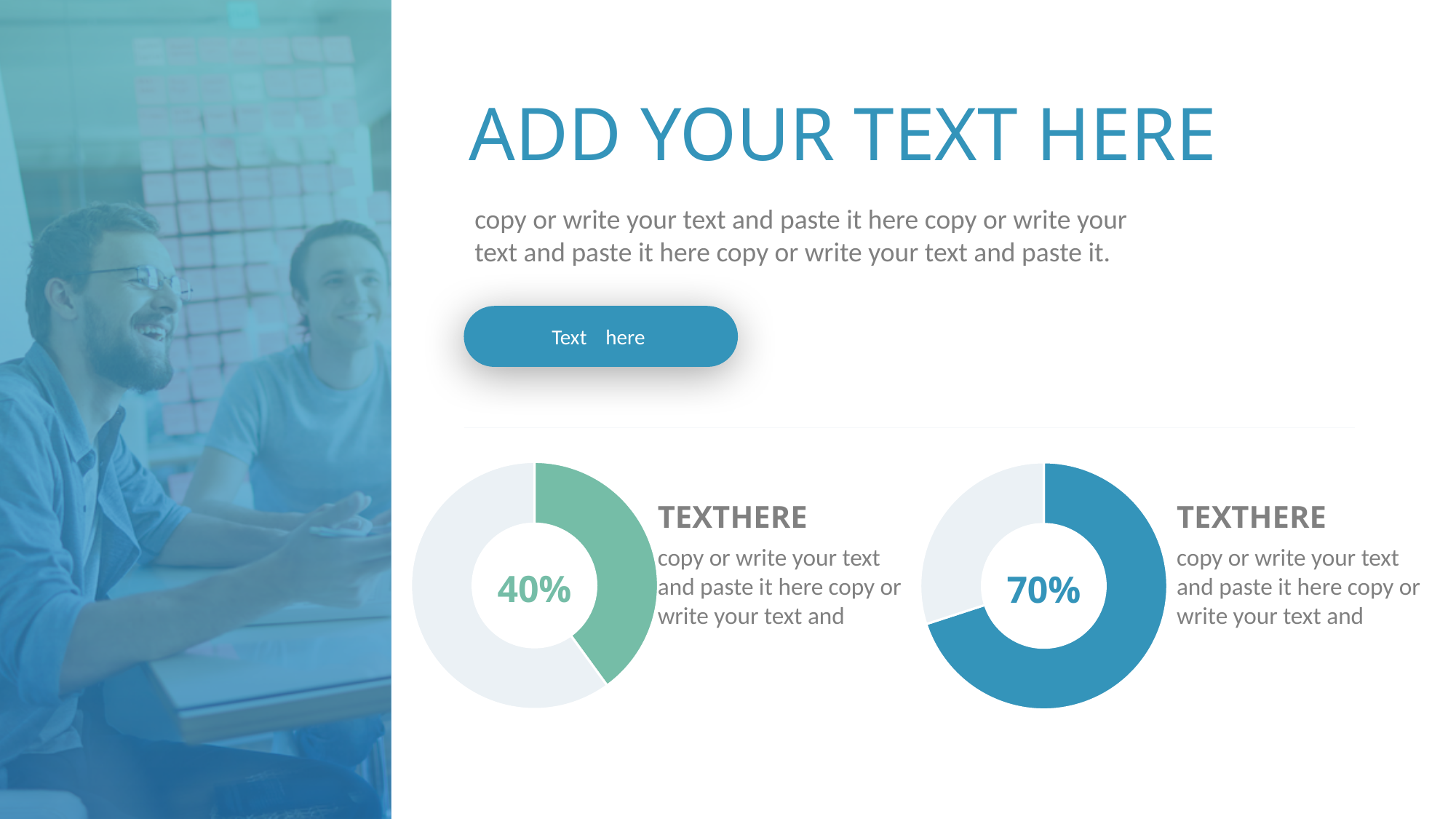
Is the value shown in the right donut chart greater or less than 50%? greater What kind of chart is used on the left side of the slide to show 40%? donut chart How many donut charts are on the slide? 2 In the right donut chart, what share of the ring is filled with the blue colour? 70% What kind of chart is used on the right side of the slide to show 70%? donut chart What percentage is shown in the centre of the right donut chart? 70% What percentage is shown in the centre of the left donut chart? 40% Which donut chart shows the larger percentage, the left one or the right one? the right one What is the difference between the percentage in the right donut chart and the percentage in the left donut chart? 30% What colour is the filled portion of the left donut chart? green In the left donut chart, what share of the ring is filled with the green colour? 40% Is the value shown in the left donut chart greater or less than 50%? less